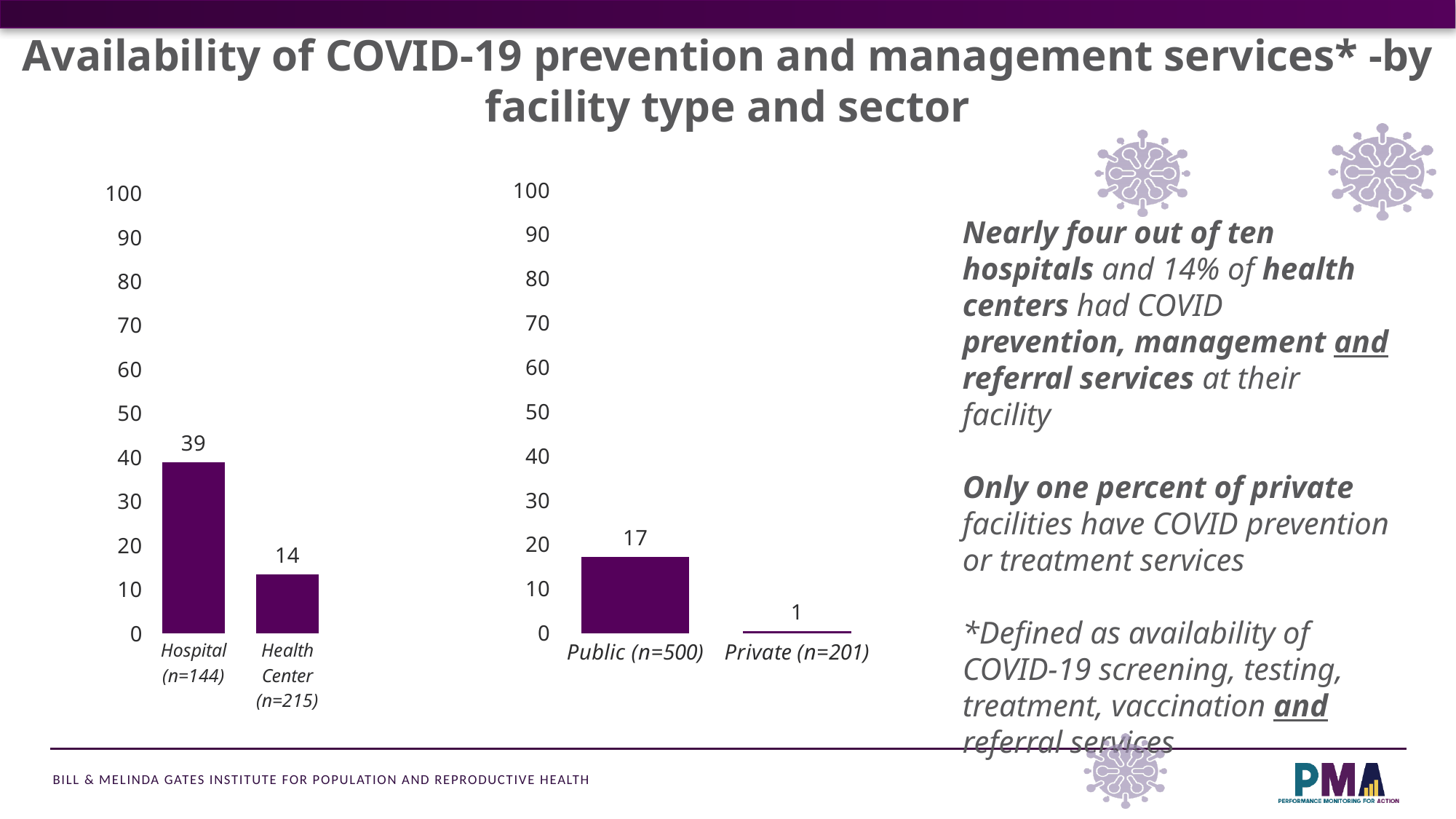
In the right chart (by sector), which category has the lowest value? Private (n=201) How many categories are shown in the left chart (by facility type)? 2 What is the maximum value shown on the y axis of the left chart (by facility type)? 100 In the right chart (by sector), what is the difference between the Public and Private values? 16 In the left chart (by facility type), what is the value for Hospital (n=144)? 39 In the right chart (by sector), what is the value for Public (n=500)? 17 In the right chart (by sector), what is the value for Private (n=201)? 1 In the left chart (by facility type), what is the value for Health Center (n=215)? 14 What kind of chart is the right chart (by sector)? Bar chart In the left chart (by facility type), which category has the highest value? Hospital (n=144) In the right chart (by sector), is the value for Public greater or less than 20? less In the left chart (by facility type), what is the difference between the Hospital and Health Center values? 25